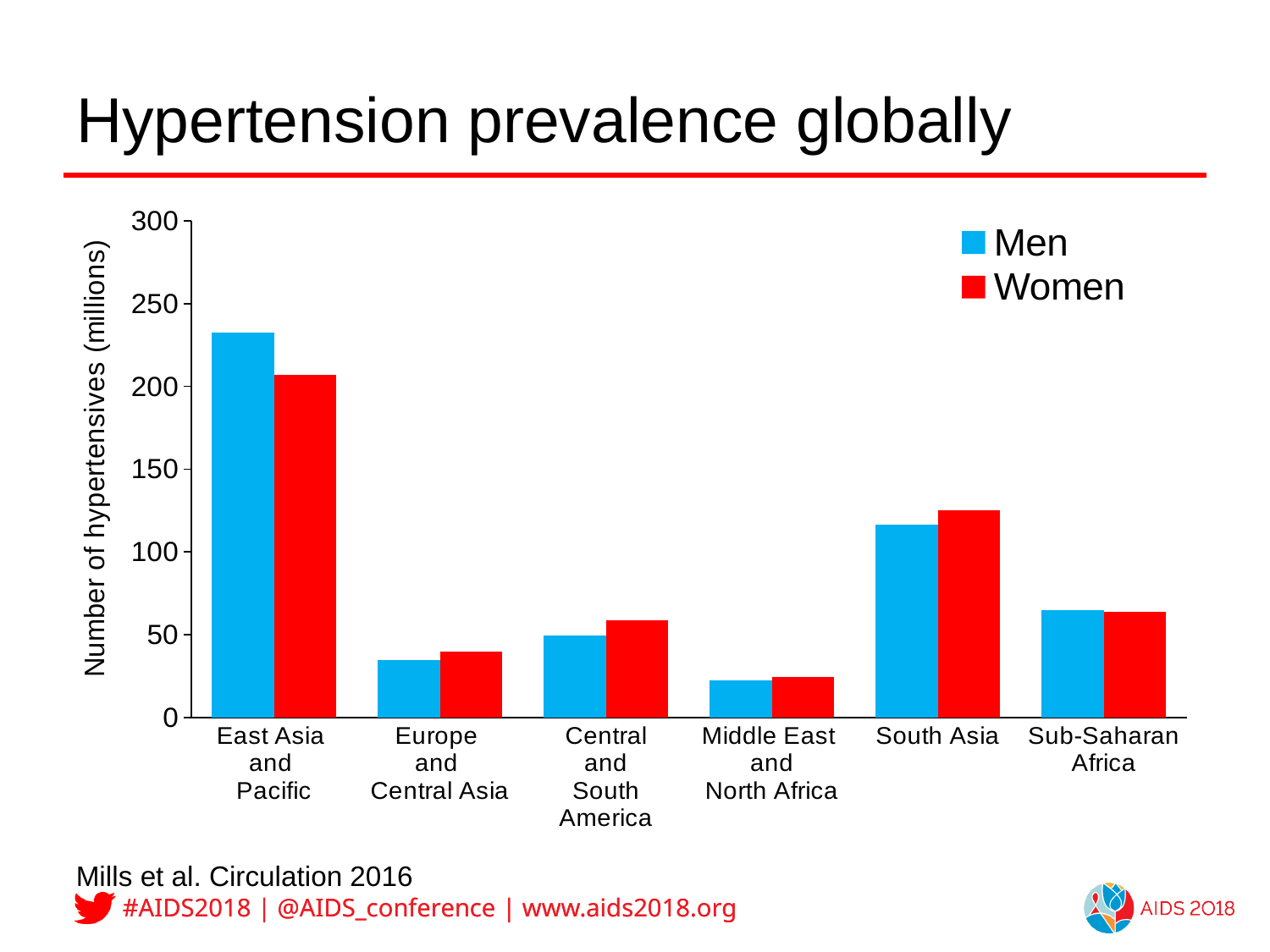
What colour represents Women in the chart? red Which region has the highest number of hypertensive men? East Asia and Pacific Is the value for Women in Middle East and North Africa greater or less than 50? less Is the value for Women in South Asia greater or less than 100? greater In South Asia, which is larger, the value for Men or for Women? Women How many regions are shown on the x axis? 6 Which region has the lowest number of hypertensive women? Middle East and North Africa In East Asia and Pacific, which is larger, the value for Men or for Women? Men Is the value for Men in East Asia and Pacific greater or less than 200? greater How many series does the legend list? 2 What kind of chart is shown on the slide? bar chart